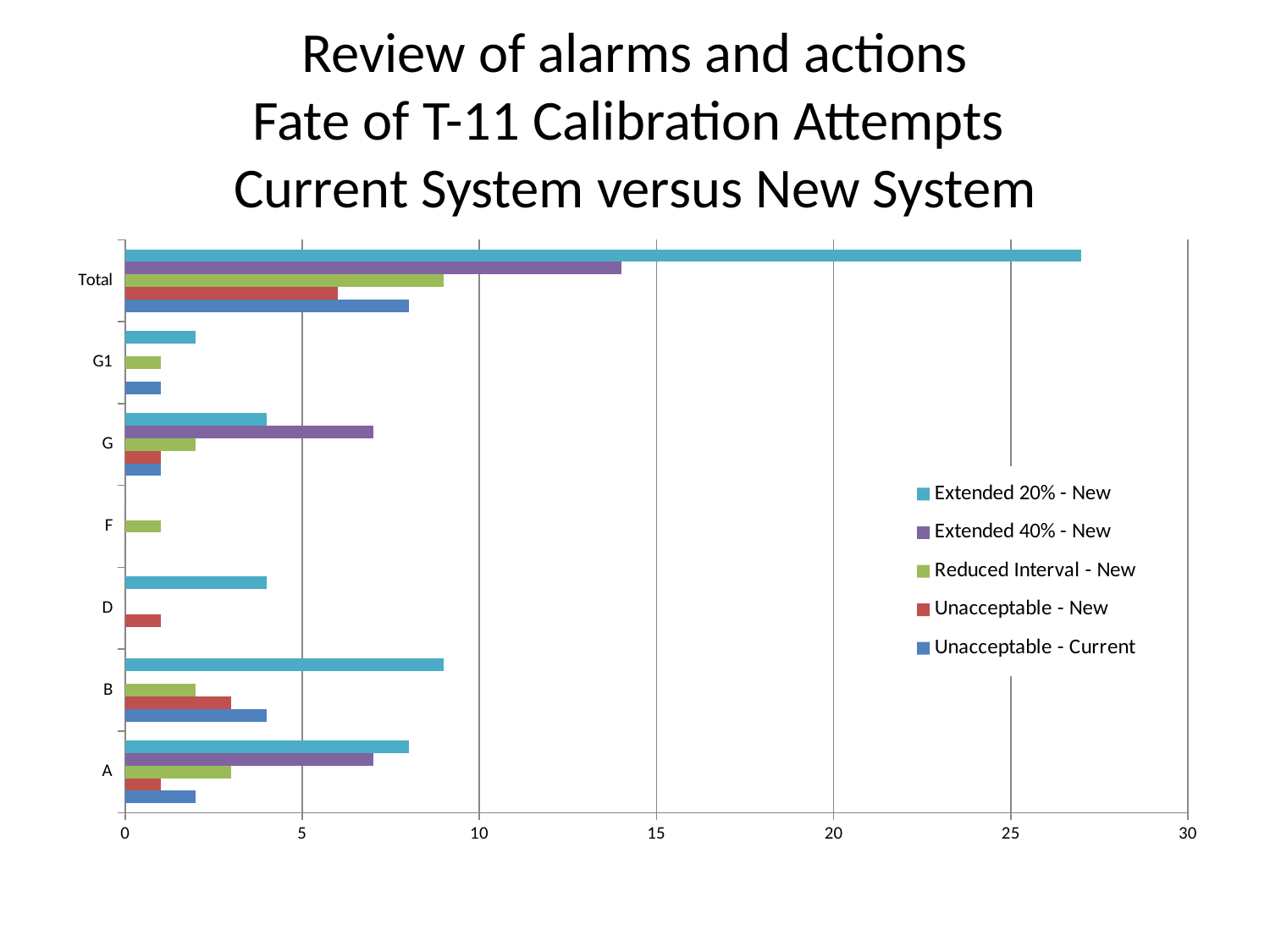
In category G, which is larger: Extended 20% - New or Extended 40% - New? Extended 40% - New Is the value for Extended 40% - New in category G greater or less than 5? greater Is the value for Reduced Interval - New in the Total category greater or less than 10? less How many categories are shown on the vertical axis? 7 Which series has the highest value in the Total category? Extended 20% - New Which series has the lowest value in the Total category? Unacceptable - New Is the value for Extended 40% - New in the Total category greater or less than 10? greater What is the maximum value shown on the horizontal axis? 30 How many series does the legend list? 5 What kind of chart is shown on the slide? Bar chart